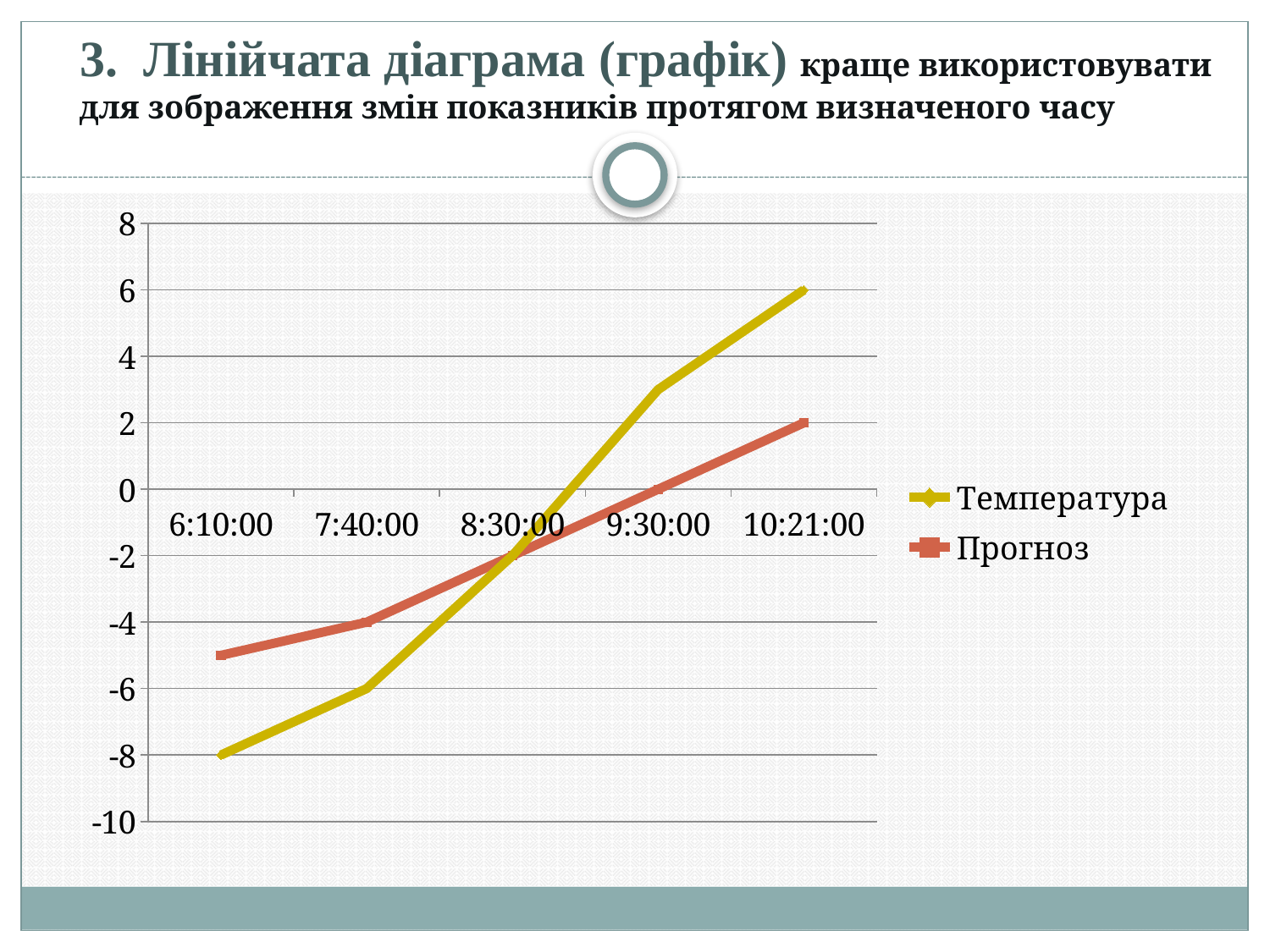
What is the value of Прогноз at 10:21:00? 2 What is the value of Температура at 10:21:00? 6 What kind of chart is shown on the slide? line chart What is the value of Температура at 6:10:00? -8 At which time is the Температура value lowest? 6:10:00 At which time is the Прогноз value highest? 10:21:00 How many time points are plotted along the x axis? 5 Do the Температура values rise or fall from 6:10:00 to 10:21:00? rise How many series does the legend list? 2 What is the value of Прогноз at 9:30:00? 0 Which series has the larger value at 6:10:00, Температура or Прогноз? Прогноз What is the difference between Температура and Прогноз at 10:21:00? 4